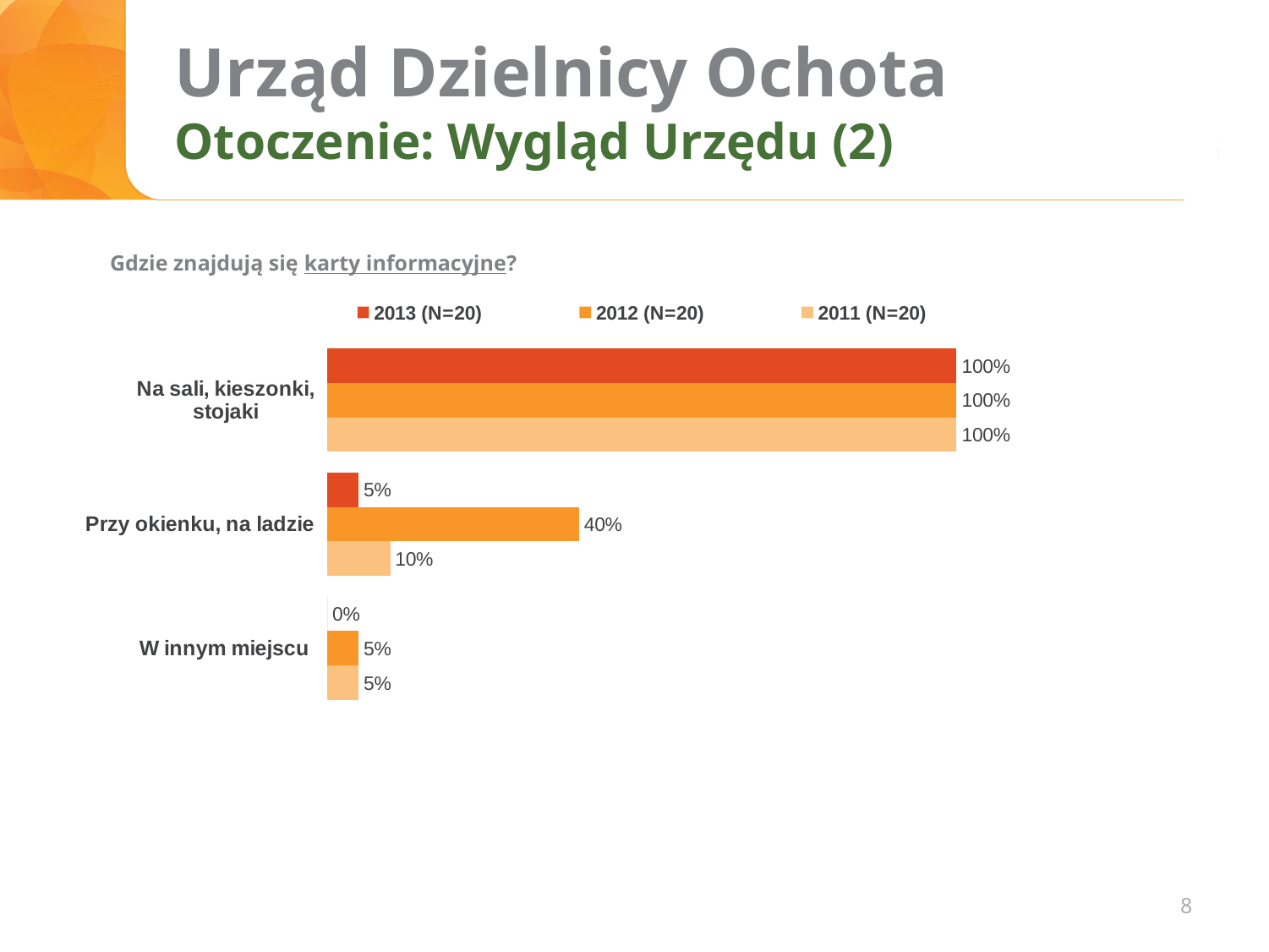
What kind of chart is shown on the slide? Bar chart What is the value for 'Na sali, kieszonki, stojaki' in the 2013 (N=20) series? 100% Which category has the highest value in the 2012 (N=20) series? Na sali, kieszonki, stojaki What question is the chart answering, as written above it? Gdzie znajdują się karty informacyjne? How many categories are shown on the chart? 3 What is the difference between the 2012 (N=20) and 2013 (N=20) values for 'Przy okienku, na ladzie'? 35% What is the value for 'Przy okienku, na ladzie' in the 2012 (N=20) series? 40% For 'Przy okienku, na ladzie', which series has the larger value: 2012 (N=20) or 2011 (N=20)? 2012 (N=20) What is the value for 'Przy okienku, na ladzie' in the 2011 (N=20) series? 10% What is the value for 'W innym miejscu' in the 2013 (N=20) series? 0% Which category has the lowest value in the 2013 (N=20) series? W innym miejscu How many series does the legend list? 3